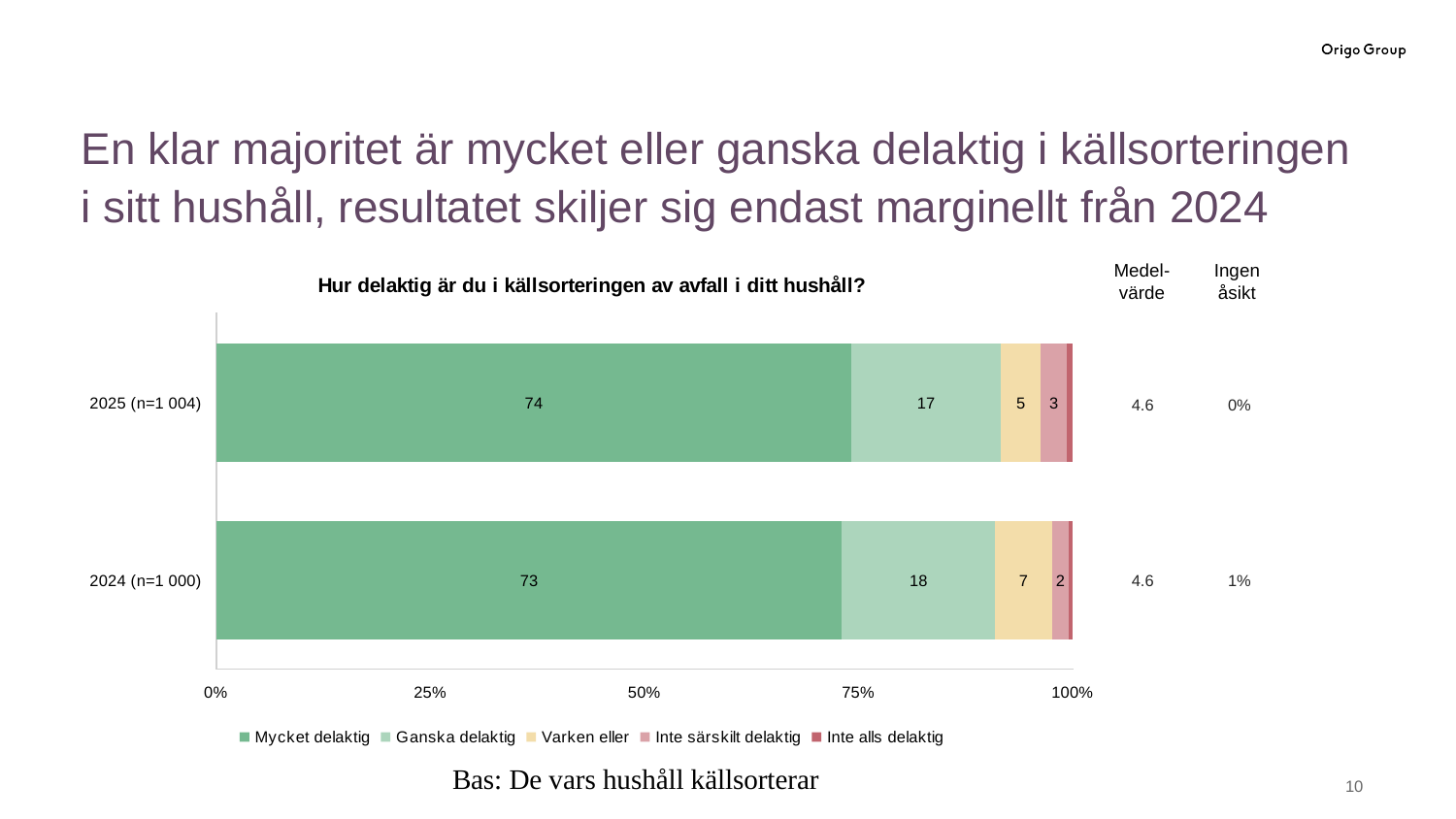
What is the value for Ganska delaktig in 2024 (n=1 000)? 18 What is the Ingen åsikt share shown for 2024 (n=1 000)? 1% Which year has the larger Varken eller value, 2025 or 2024? 2024 What is the difference between the Mycket delaktig values for 2025 and 2024? 1 What kind of chart is shown on the slide? Stacked bar chart How many series does the legend list? 5 What is the value for Inte särskilt delaktig in 2025 (n=1 004)? 3 What is the value for Varken eller in 2024 (n=1 000)? 7 What is the value for Mycket delaktig in 2025 (n=1 004)? 74 What is the Medelvärde shown for 2025 (n=1 004)? 4.6 How many categories (years) are shown on the chart? 2 Is the Mycket delaktig segment for 2025 (n=1 004) greater or less than 50%? greater